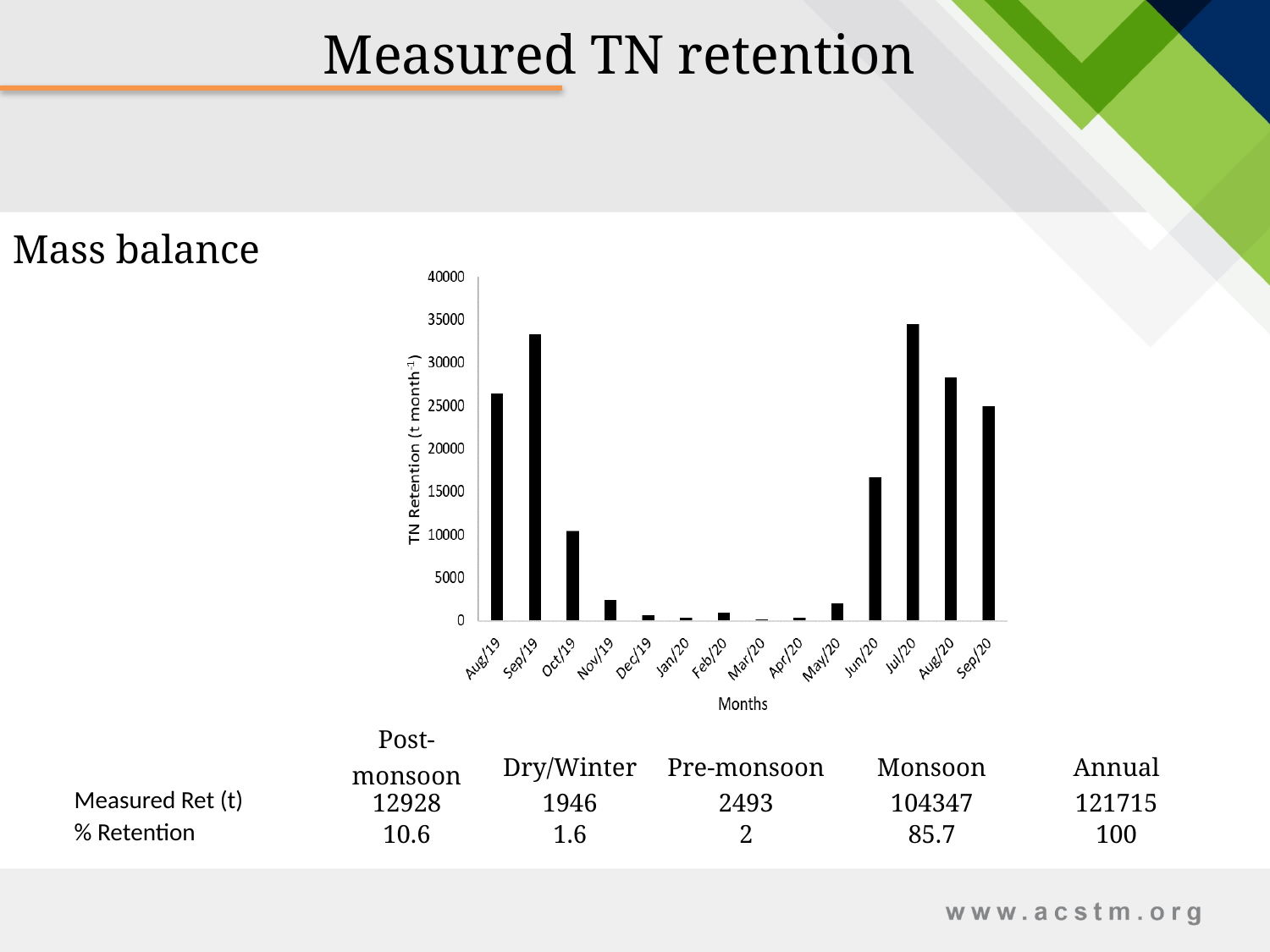
Is the TN retention for Aug/20 greater or less than 25000? greater Is the TN retention for Oct/19 greater or less than 15000? less How many months are plotted on the x axis of the chart? 14 Which has a higher TN retention, Jun/20 or Sep/20? Sep/20 Is the TN retention for Jun/20 greater or less than 15000? greater Which has a higher TN retention, Aug/19 or Oct/19? Aug/19 Which month has the highest TN retention in the chart? Jul/20 What kind of chart is shown on the slide? bar chart What is the label of the y axis of the chart? TN Retention (t month-1) Do the TN retention values rise or fall from Sep/19 to Mar/20? fall